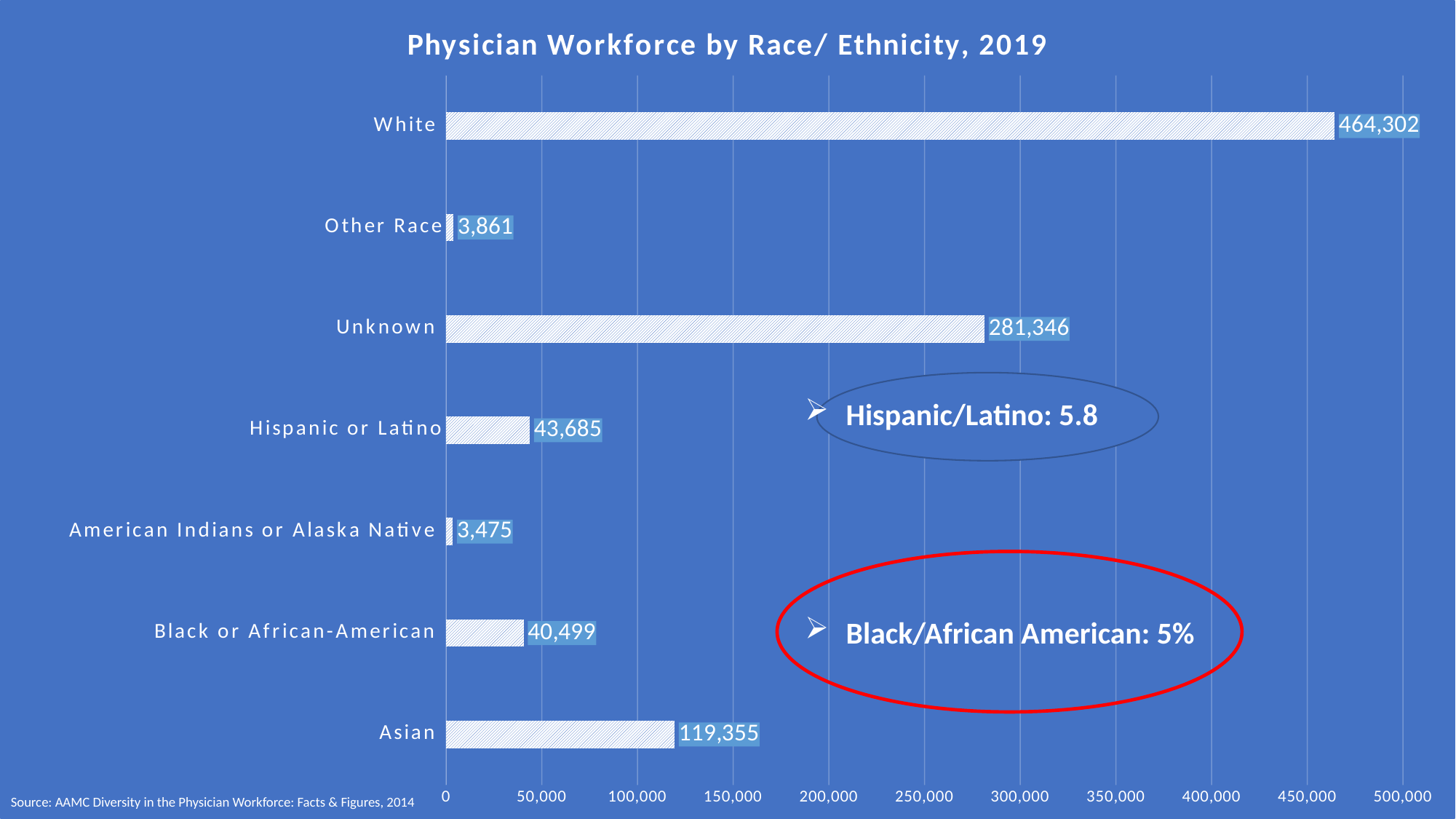
What is the difference between the values for White and Unknown? 182,956 What is the value for Asian? 119,355 What is the value for Unknown? 281,346 What is the title of the chart? Physician Workforce by Race/ Ethnicity, 2019 Which is larger, the value for Asian or the value for Hispanic or Latino? Asian Which category has the highest value? White What is the value for Black or African-American? 40,499 What is the difference between the values for Hispanic or Latino and Black or African-American? 3,186 How many categories are shown in the chart? 7 What is the value for White? 464,302 Which category has the lowest value? American Indians or Alaska Native What kind of chart is shown on the slide? Bar chart